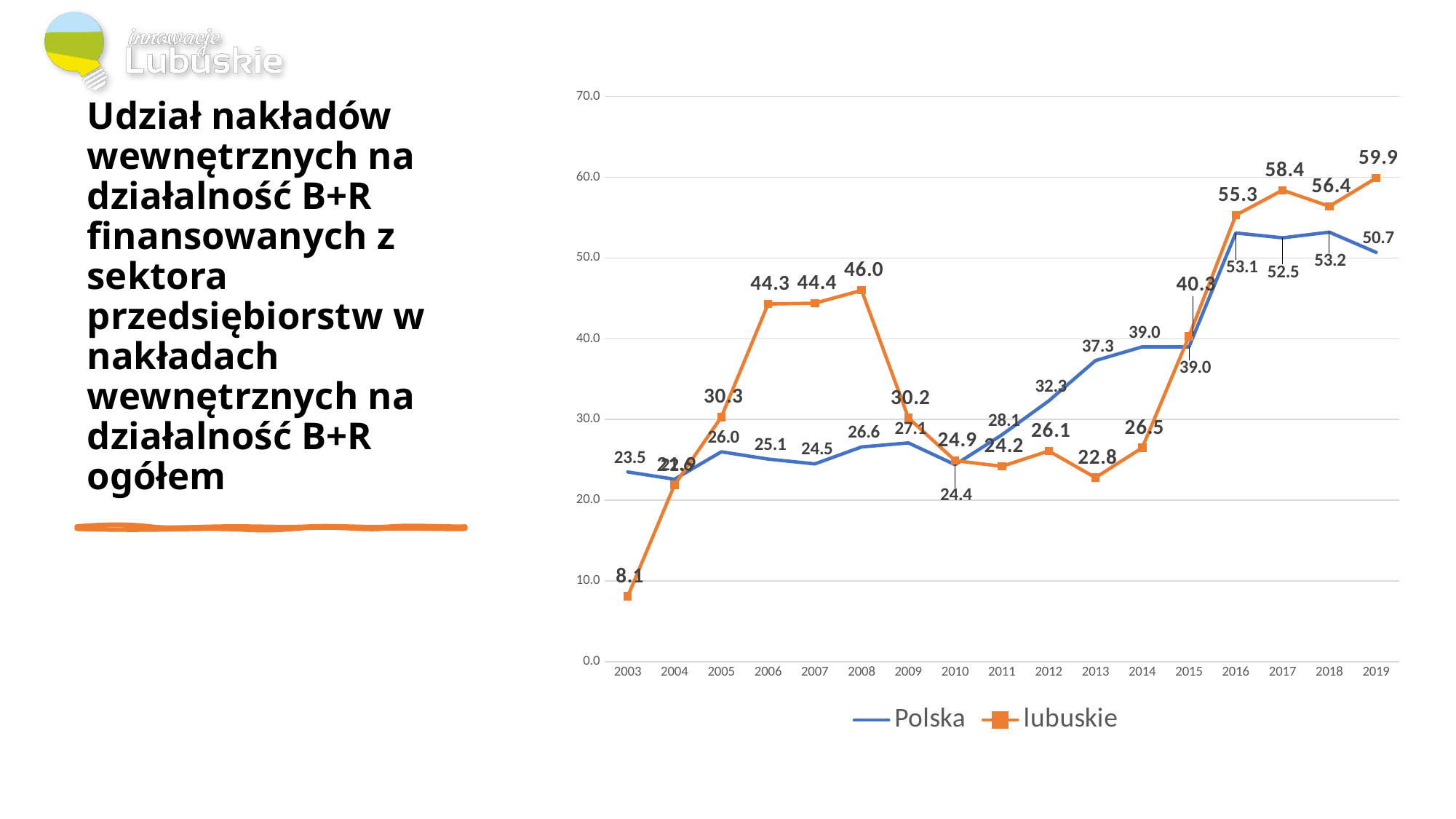
What is the value for Polska in 2016? 53.1 Which series has the higher value in 2013, Polska or lubuskie? Polska What type of chart is shown on the slide? line chart How many years are shown on the x axis? 17 What is the value for lubuskie in 2003? 8.1 What is the difference between the lubuskie and Polska values in 2008? 19.4 Is the value for lubuskie in 2017 greater or less than 50.0? greater How many series does the legend list? 2 Does the Polska series rise or fall between 2010 and 2016? rise What is the value for lubuskie in 2019? 59.9 In which year is the lubuskie series at its lowest? 2003 In which year is the lubuskie series at its highest? 2019